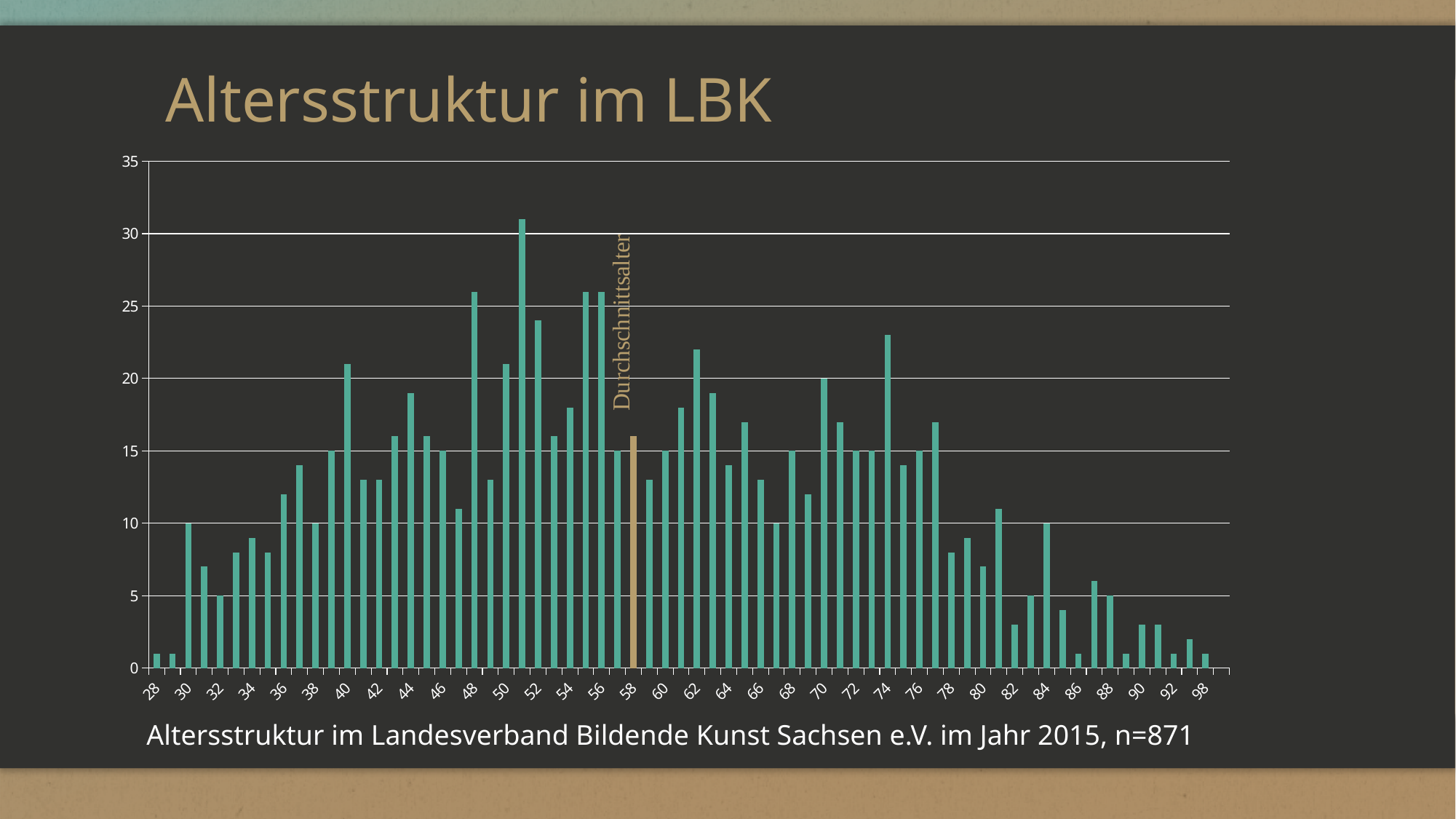
What is the title of the chart on the slide? Altersstruktur im LBK What is the value for age 30? 10 What is the value for age 70? 20 What kind of chart is shown on the slide? bar chart Do the values generally rise or fall along the x axis from age 60 to age 98? fall Is the value for age 62 greater or less than 20? greater Which is larger, the value for age 74 or the value for age 90? age 74 Is the value for age 90 greater or less than 5? less Is the value for age 80 greater or less than 10? less What is the value for age 84? 10 What is the value for age 88? 5 Which age does the gold-coloured bar labelled "Durchschnittsalter" mark? 58